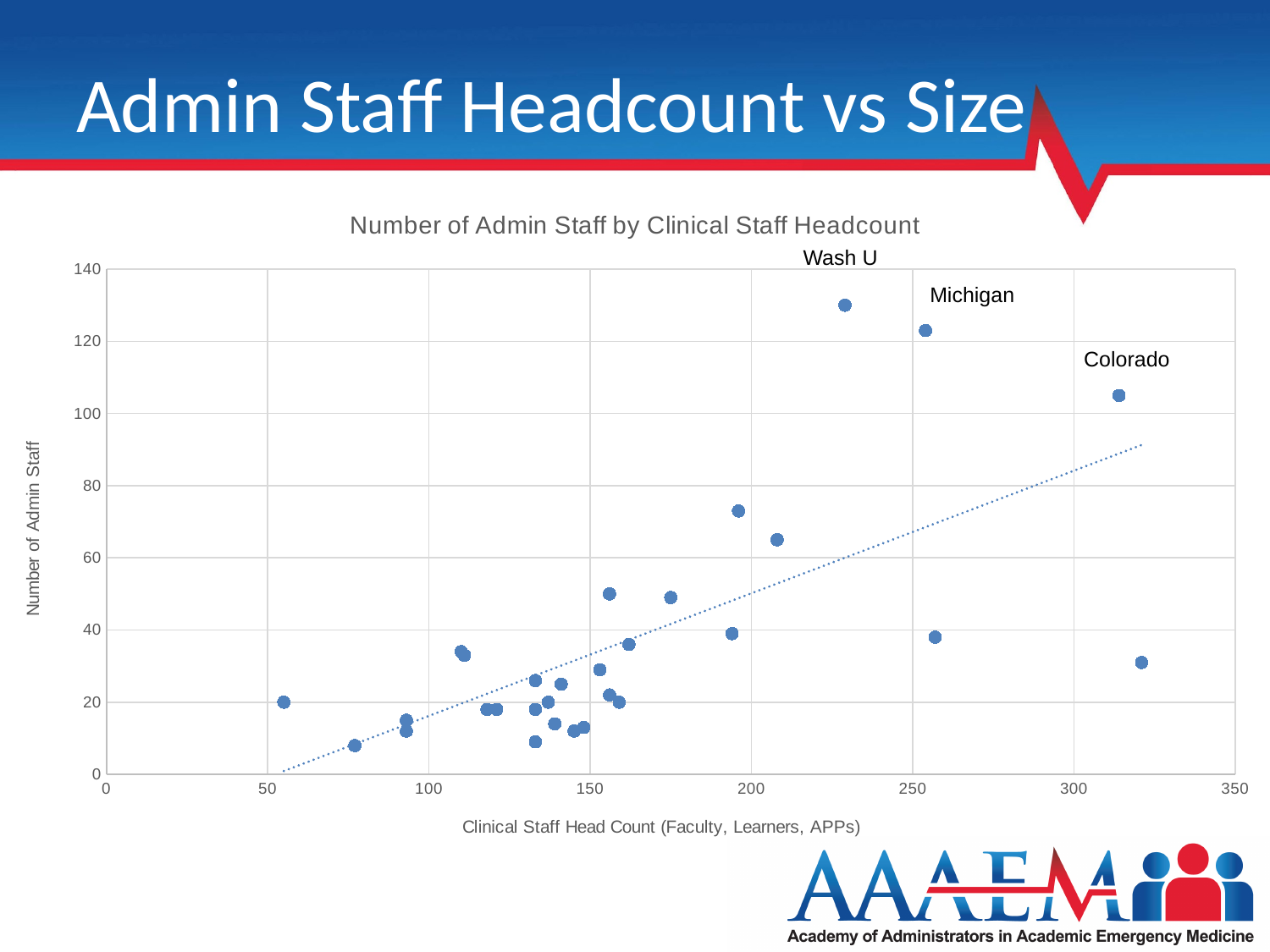
Which labeled point has the largest clinical staff head count? Colorado Which has more admin staff, Wash U or Michigan? Wash U According to the dotted trend line, does the number of admin staff generally rise or fall as clinical staff head count increases? Rise Of the three labeled points (Wash U, Michigan, Colorado), which has the lowest number of admin staff? Colorado What is the label of the horizontal axis? Clinical Staff Head Count (Faculty, Learners, APPs) Which has more admin staff, Michigan or Colorado? Michigan Is the number of admin staff for Wash U greater or less than 120? greater What kind of chart is shown on the slide? Scatter chart Is the number of admin staff for Colorado greater or less than 120? less Is the number of admin staff for Michigan greater or less than 100? greater Of the three labeled points (Wash U, Michigan, Colorado), which has the highest number of admin staff? Wash U What is the title of the chart? Number of Admin Staff by Clinical Staff Headcount